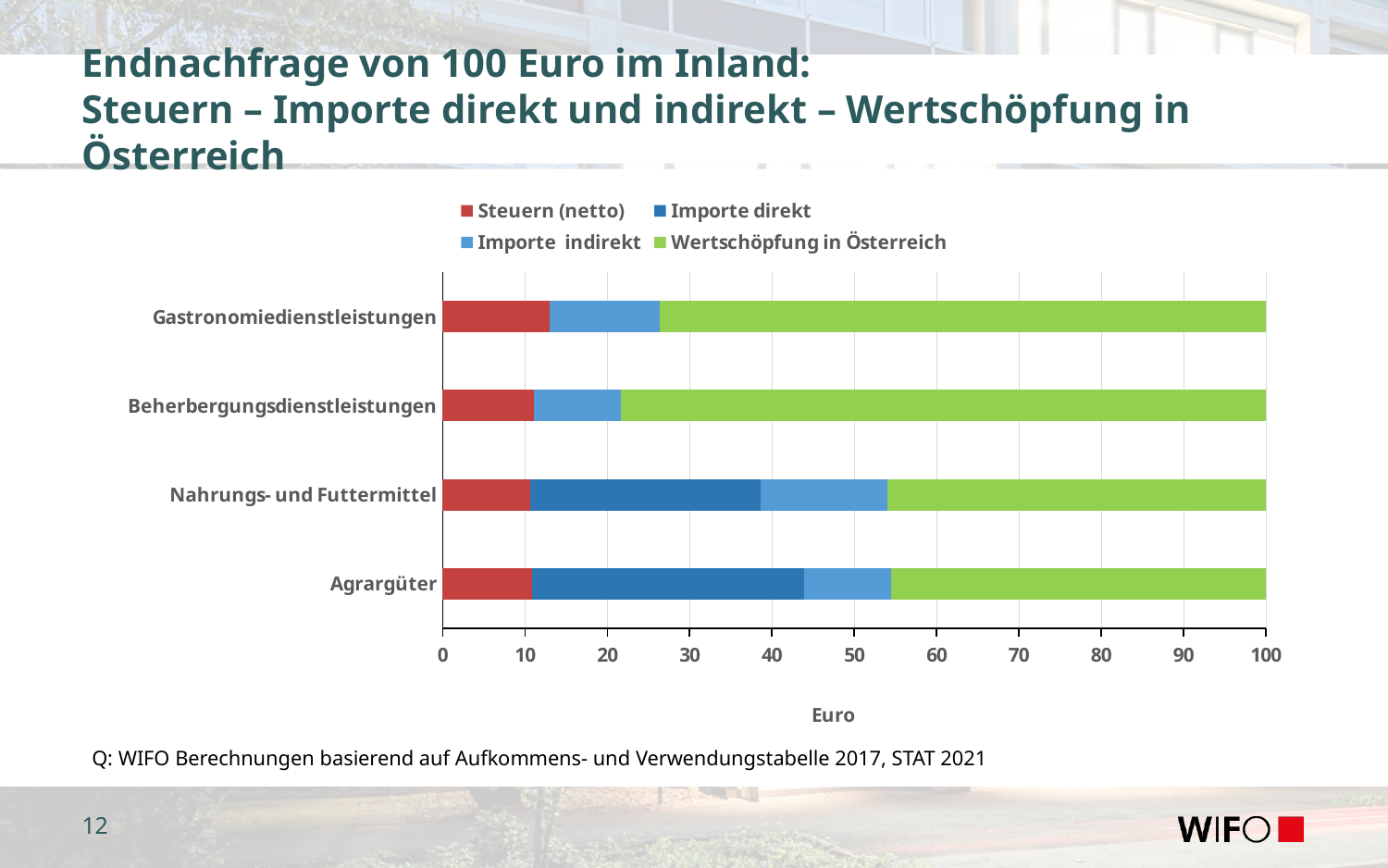
What kind of chart is shown on the slide? Stacked bar chart Is the Importe direkt segment for Nahrungs- und Futtermittel greater or less than 20? greater What is the total of the stacked bar for Agrargüter? 100 Is the Wertschöpfung in Österreich segment for Gastronomiedienstleistungen greater or less than 70? greater Which has the larger Wertschöpfung in Österreich segment, Gastronomiedienstleistungen or Agrargüter? Gastronomiedienstleistungen How many series does the legend list? 4 Is the Wertschöpfung in Österreich segment for Agrargüter greater or less than 50? less What is the label of the x axis? Euro How many categories are plotted on the y axis of the chart? 4 Which category has the largest Importe direkt segment? Agrargüter Which category has the largest Wertschöpfung in Österreich segment? Beherbergungsdienstleistungen